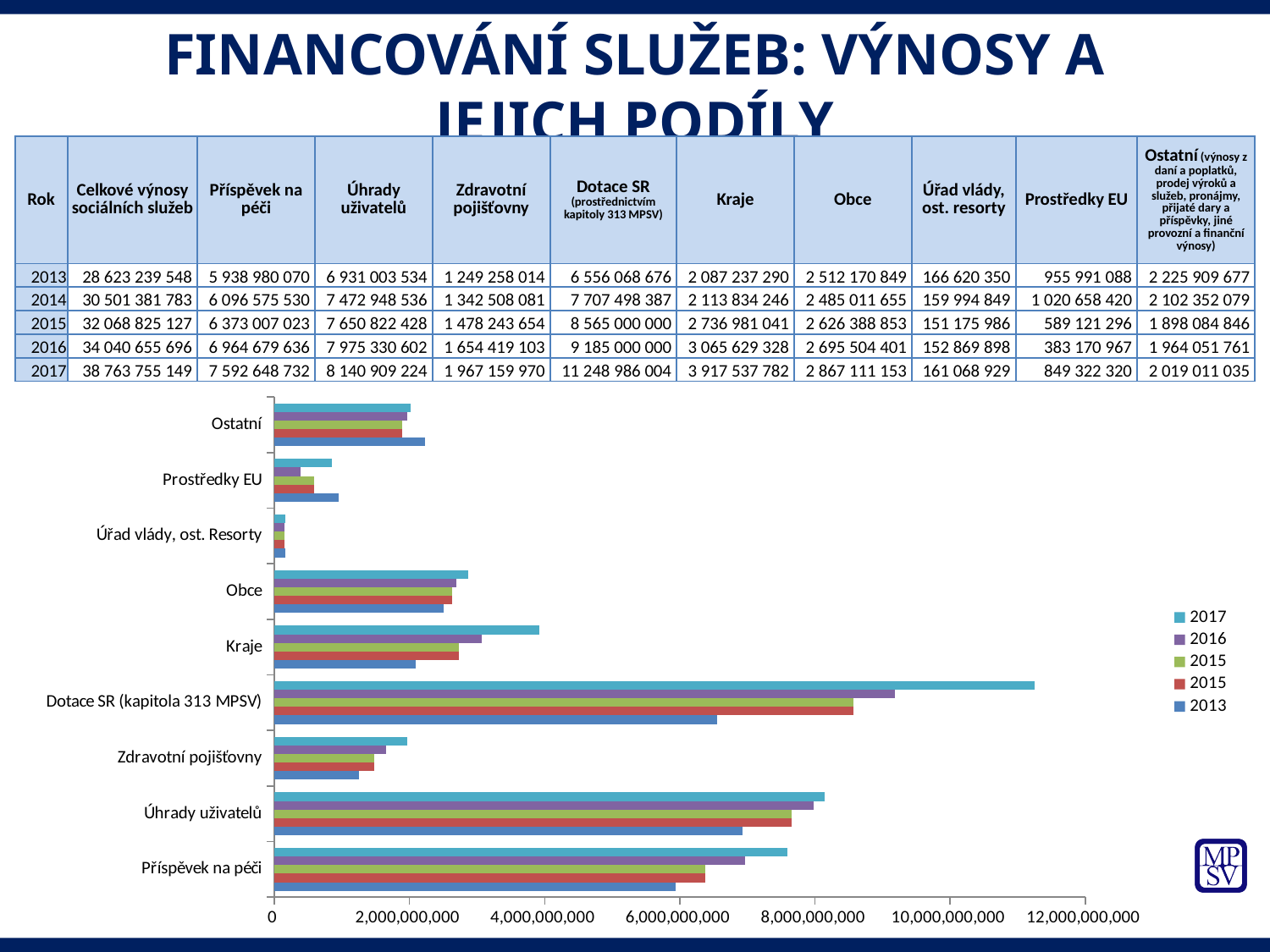
How many categories are plotted on the chart's vertical axis? 9 Is the 2013 value for Prostředky EU greater or less than 2,000,000,000? less Which category has the longest bar for 2017? Dotace SR (kapitola 313 MPSV) Which year label appears twice in the chart legend? 2015 Is the 2017 value for Dotace SR (kapitola 313 MPSV) greater or less than 10,000,000,000? greater How many series does the chart legend list? 5 Is the 2017 value for Obce greater or less than 2,000,000,000? greater What kind of chart is shown on the slide? bar chart For 2017, which is larger: Kraje or Obce? Kraje Do the bars for Dotace SR (kapitola 313 MPSV) rise or fall from 2013 to 2017? rise Which category has the shortest bars in the chart? Úřad vlády, ost. Resorty